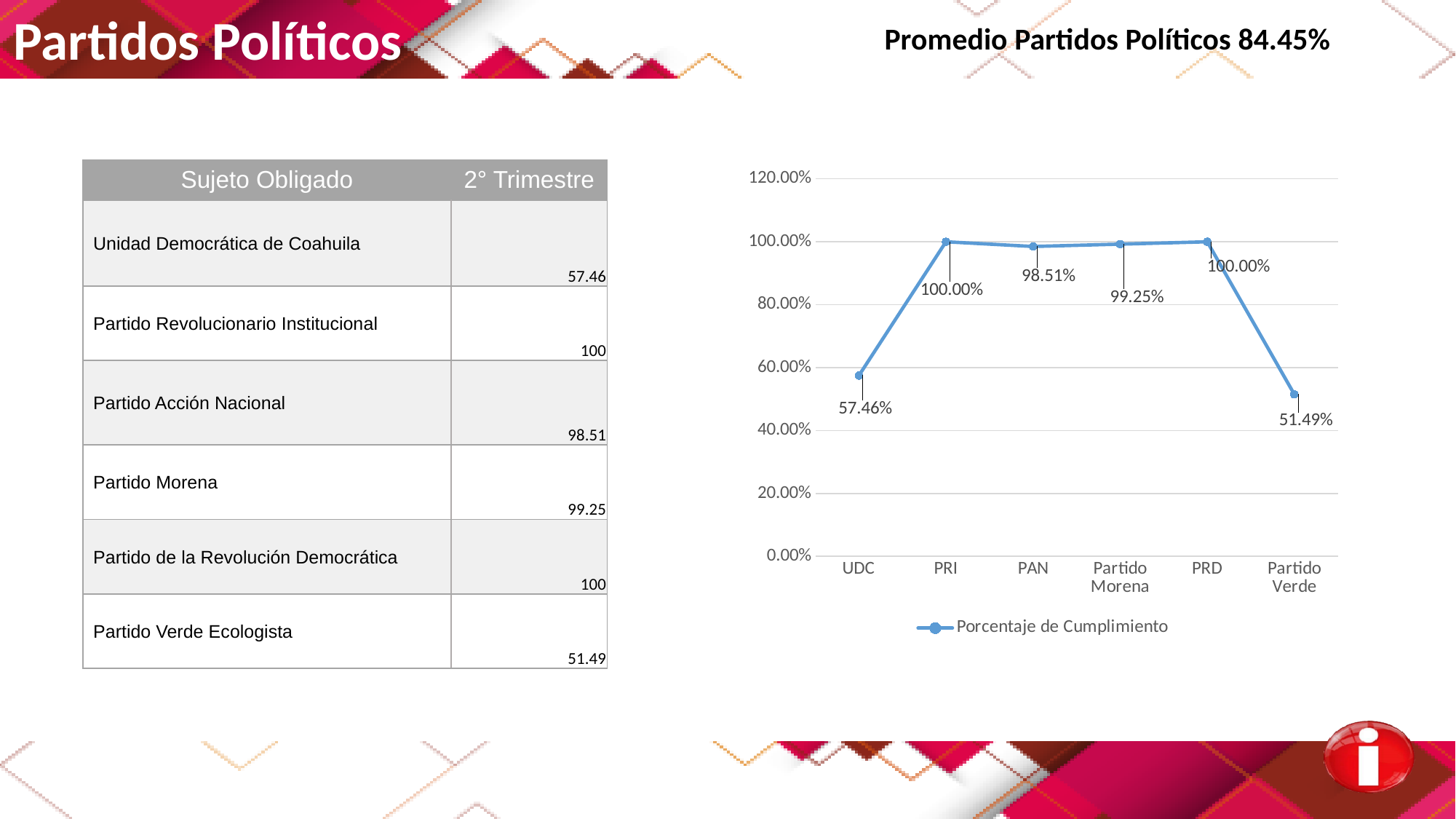
How many categories are shown on the x axis of the chart? 6 Is the value for UDC greater or less than 60.00%? less What is the value for PAN in the chart? 98.51% What series name does the chart legend show? Porcentaje de Cumplimiento Which category has the lowest value in the chart? Partido Verde What is the difference between the values for UDC and Partido Verde? 5.97% What is the value for Partido Morena in the chart? 99.25% What is the difference between the values for PRI and PAN? 1.49% What is the value for UDC in the chart? 57.46% What is the value for Partido Verde in the chart? 51.49% Which is larger, the value for PAN or the value for Partido Morena? Partido Morena What kind of chart is shown on the slide? line chart